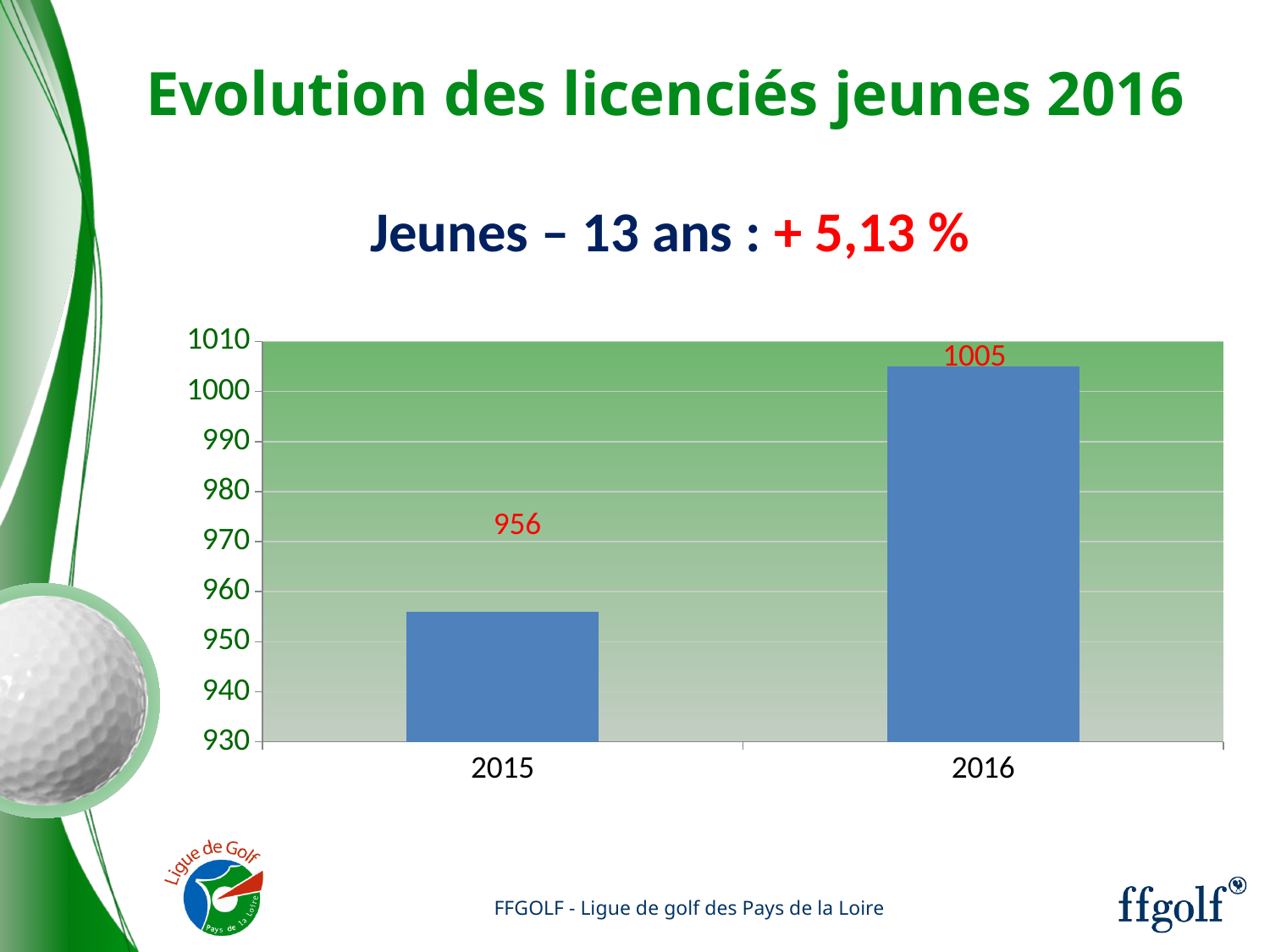
Is the value for 2016 greater or less than 1000? greater Is the value for 2015 greater or less than 960? less How many categories are shown on the x axis? 2 Which year has the lowest value? 2015 Which is larger, the value for 2015 or the value for 2016? 2016 Do the values rise or fall from 2015 to 2016? rise What kind of chart is shown on the slide? bar chart What is the value for 2015? 956 What is the difference between the values for 2016 and 2015? 49 What is the value for 2016? 1005 Which year has the highest value? 2016 What percentage change is stated in the subtitle above the chart? + 5,13 %